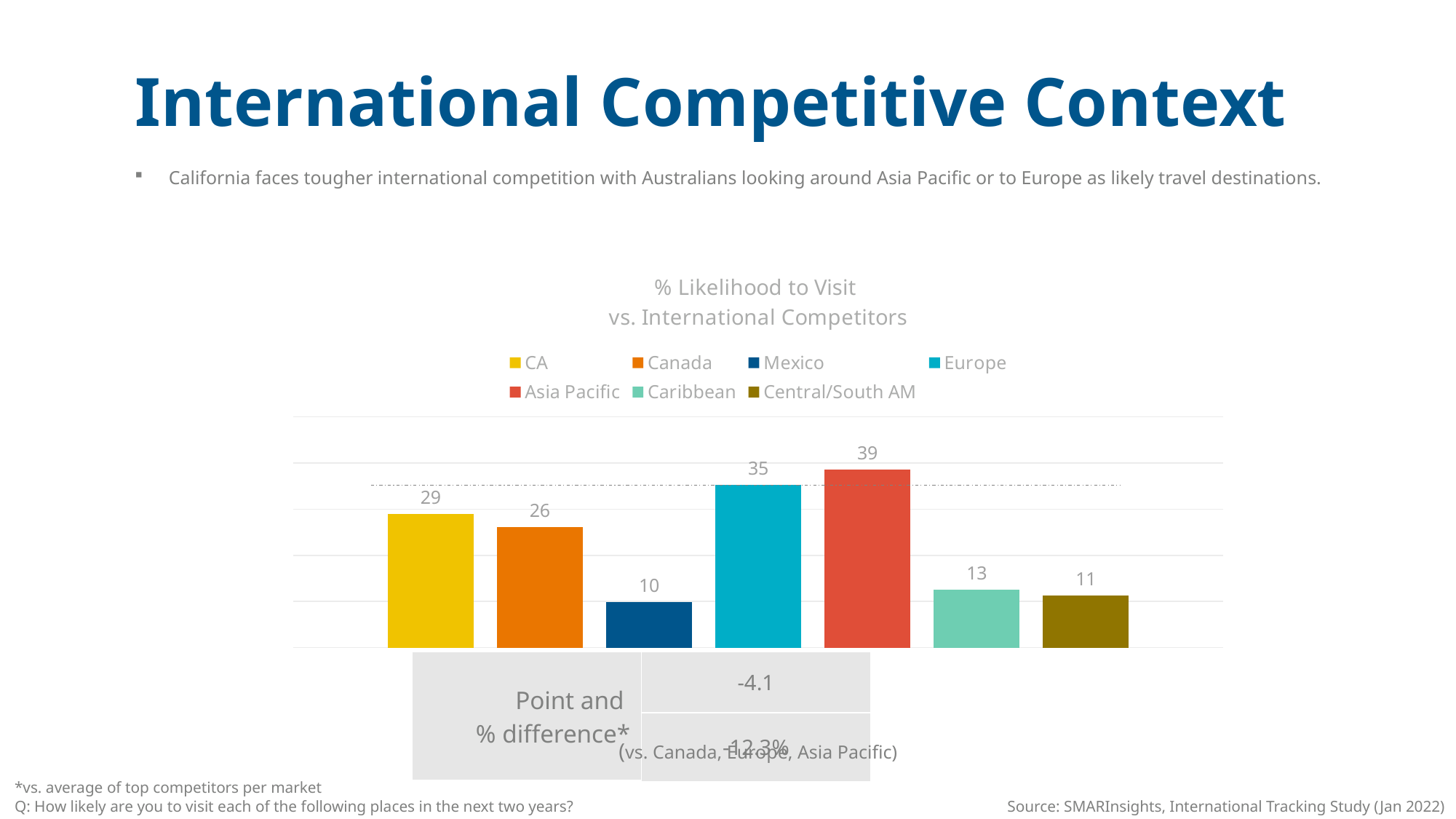
What is the difference between the values for Caribbean and Central/South AM? 2 What is the difference between the values for Asia Pacific and CA? 10 Which has a higher value, CA or Canada? CA What is the value shown for Europe? 35 What is the % likelihood to visit value for CA? 29 What kind of chart is shown on the slide? Bar chart What is the value shown for Mexico? 10 How many destinations are plotted in the chart? 7 Which destination has the lowest % likelihood to visit? Mexico Which destination has the highest % likelihood to visit? Asia Pacific How many entries does the legend list? 7 What is the title of the chart? % Likelihood to Visit vs. International Competitors